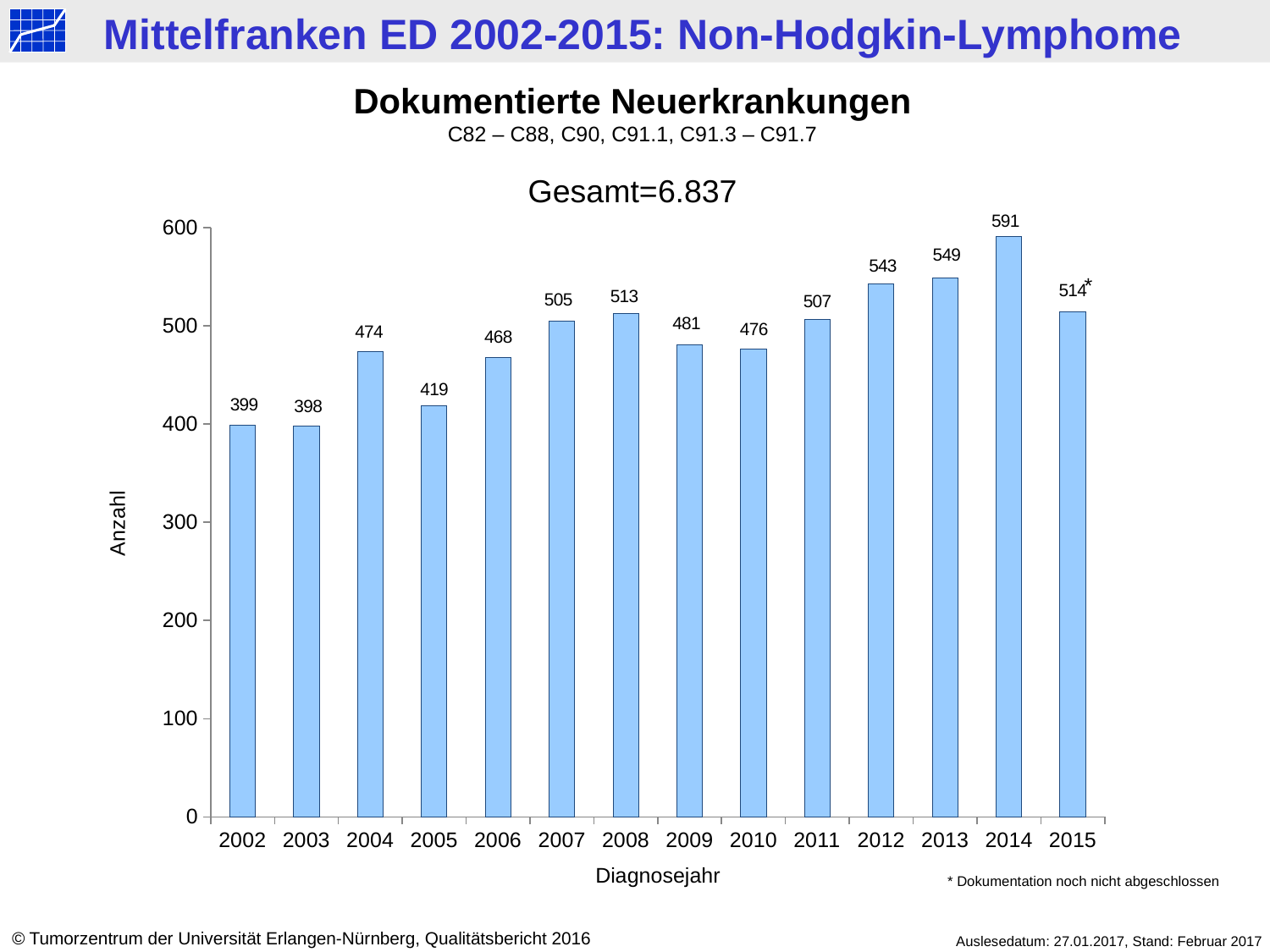
Which year has the highest value? 2014 Is the value for 2012 greater or less than 500? greater What total (Gesamt) is stated above the chart? 6.837 What kind of chart is this? bar chart Do the values generally rise or fall from 2002 to 2014? rise What is the difference between the values for 2014 and 2002? 192 What is the value for 2009? 481 How many years are shown on the x axis? 14 Which is larger, the value for 2005 or the value for 2006? 2006 What is the value for 2002? 399 What is the value for 2014? 591 Which year has the lowest value? 2003